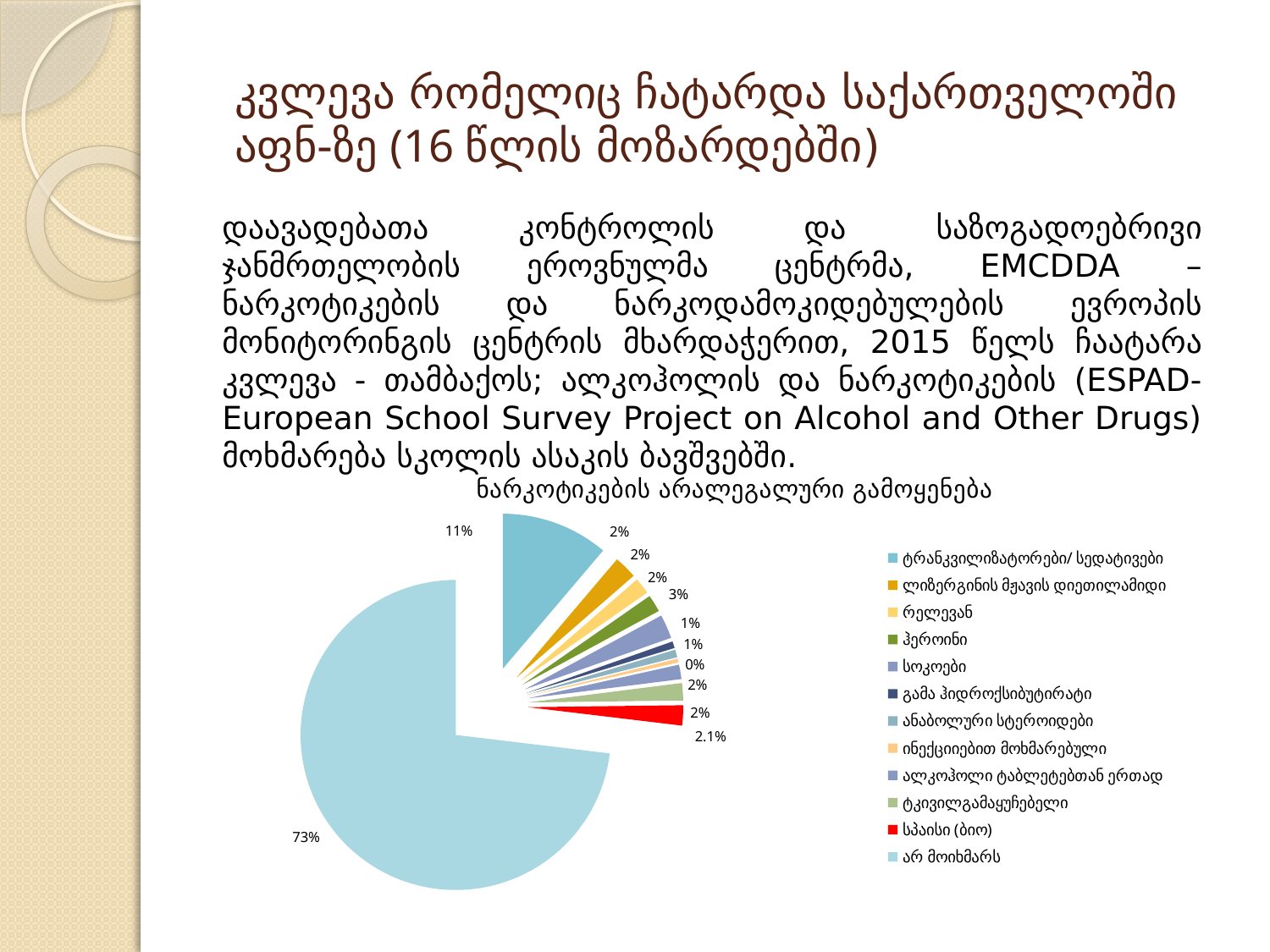
How many slices does the pie chart have? 12 What is the difference between the 'არ მოიხმარს' slice (73%) and the 'ტრანკვილიზატორები/ სედატივები' slice (11%)? 62 percentage points What share of the pie does the category 'არ მოიხმარს' take? 73% What is the title of the chart? ნარკოტიკების არალეგალური გამოყენება What kind of chart is shown on the slide? pie chart What colour is the slice for 'სპაისი (ბიო)' in the chart? red What is the value shown for the red slice, 'სპაისი (ბიო)'? 2.1% What is the value shown for 'ტრანკვილიზატორები/ სედატივები'? 11% What is the value shown for 'ინექციებით მოხმარებული'? 0% Which is larger, the slice for 'არ მოიხმარს' or the slice for 'ტრანკვილიზატორები/ სედატივები'? არ მოიხმარს How many entries does the chart legend list? 12 Which category has the largest slice of the pie? არ მოიხმარს